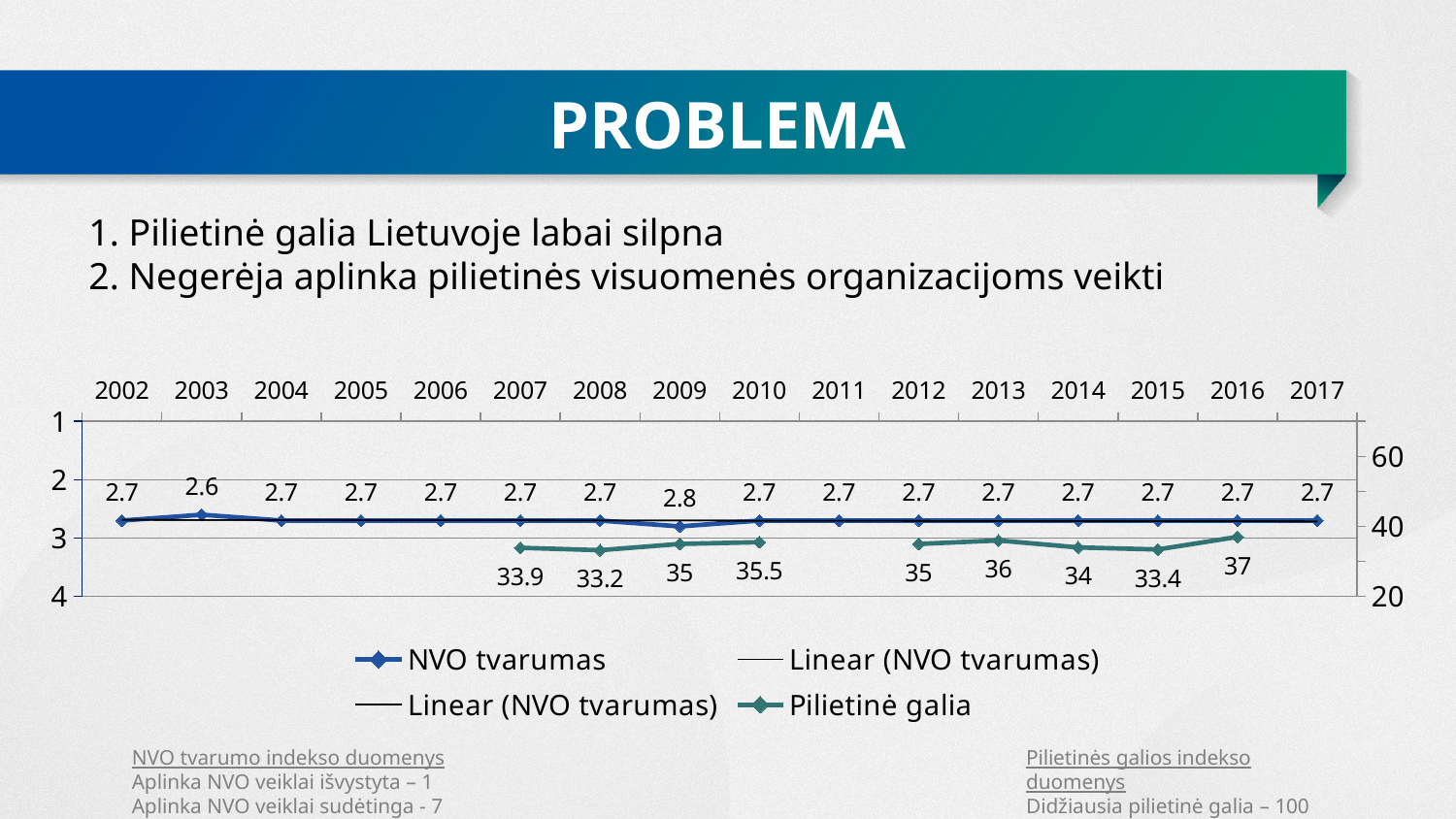
What is the value of NVO tvarumas in 2003? 2.6 In which year is NVO tvarumas highest? 2009 Which year has a higher Pilietinė galia value, 2013 or 2014? 2013 How many years are shown on the x axis? 16 How many entries does the legend list? 4 In which year is Pilietinė galia lowest? 2008 What is the difference between Pilietinė galia in 2016 and in 2008? 3.8 What is the value of Pilietinė galia in 2008? 33.2 In which year is Pilietinė galia highest? 2016 What is the value of Pilietinė galia in 2010? 35.5 What is the value of Pilietinė galia in 2016? 37 What is the value of NVO tvarumas in 2009? 2.8